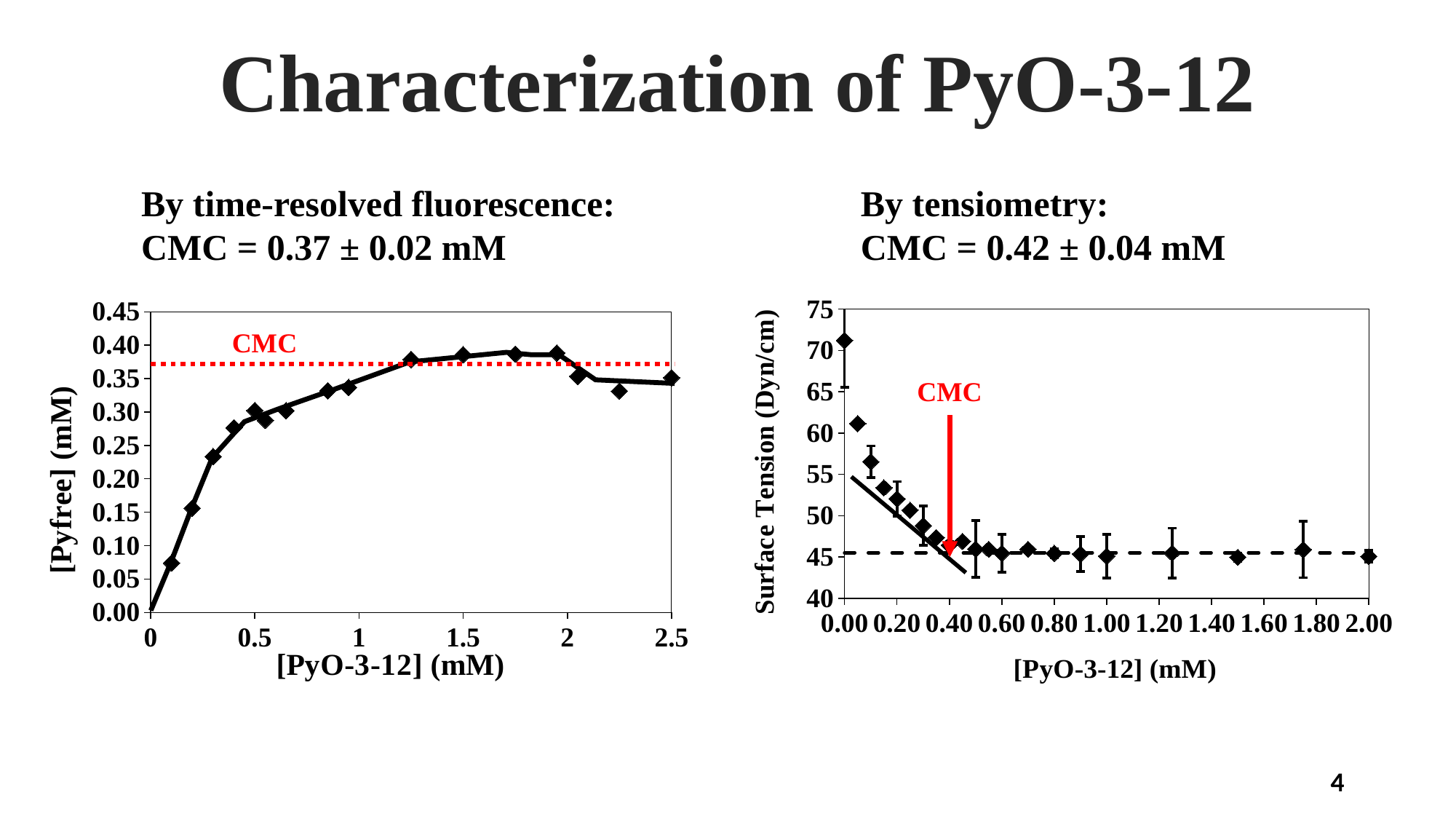
On the left chart (By time-resolved fluorescence), is the value of [Pyfree] at 0.1 mM greater or less than 0.10? less What type of chart is the left chart (By time-resolved fluorescence)? Scatter chart with line On the right chart (By tensiometry), what is the y-axis title? Surface Tension (Dyn/cm) On the left chart (By time-resolved fluorescence), is the value of [Pyfree] at 0.5 mM greater or less than 0.25? greater On the left chart (By time-resolved fluorescence), is the value of [Pyfree] at 2.5 mM greater or less than 0.30? greater On the left chart (By time-resolved fluorescence), does [Pyfree] generally rise or fall as [PyO-3-12] increases from 0 to 1.5 mM? rise On the left chart (By time-resolved fluorescence), which is larger: the value at 0.1 mM or the value at 1.5 mM? 1.5 mM On the right chart (By tensiometry), at which [PyO-3-12] concentration is the surface tension highest? 0.00 mM On the right chart (By tensiometry), does the surface tension rise or fall as [PyO-3-12] increases from 0.00 to 0.40 mM? fall On the left chart (By time-resolved fluorescence), what is the y-axis title? [Pyfree] (mM)